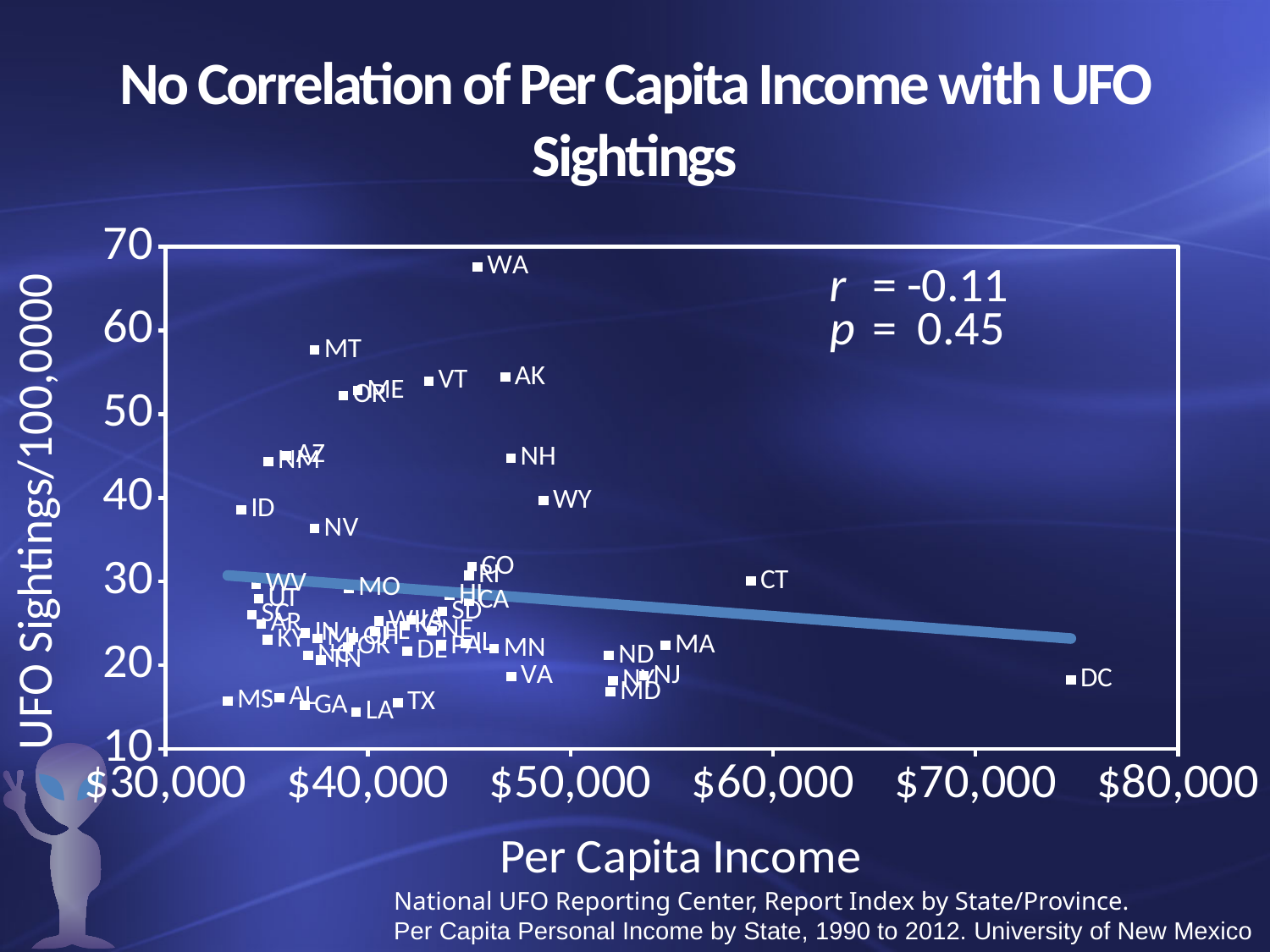
Which state has the highest UFO sightings per 100,000 on the chart? WA What correlation coefficient r is shown on the chart? -0.11 Is the per capita income for ID greater or less than $40,000? less Is the UFO sightings value for CT greater or less than 40? less Which state has a higher per capita income, DC or CT? DC Does the trend line rise or fall as per capita income increases? falls Which state has more UFO sightings per 100,000, WA or MT? WA Is the per capita income for DC greater or less than $70,000? greater What kind of chart is shown on the slide? scatter plot Which state has the highest per capita income on the chart? DC